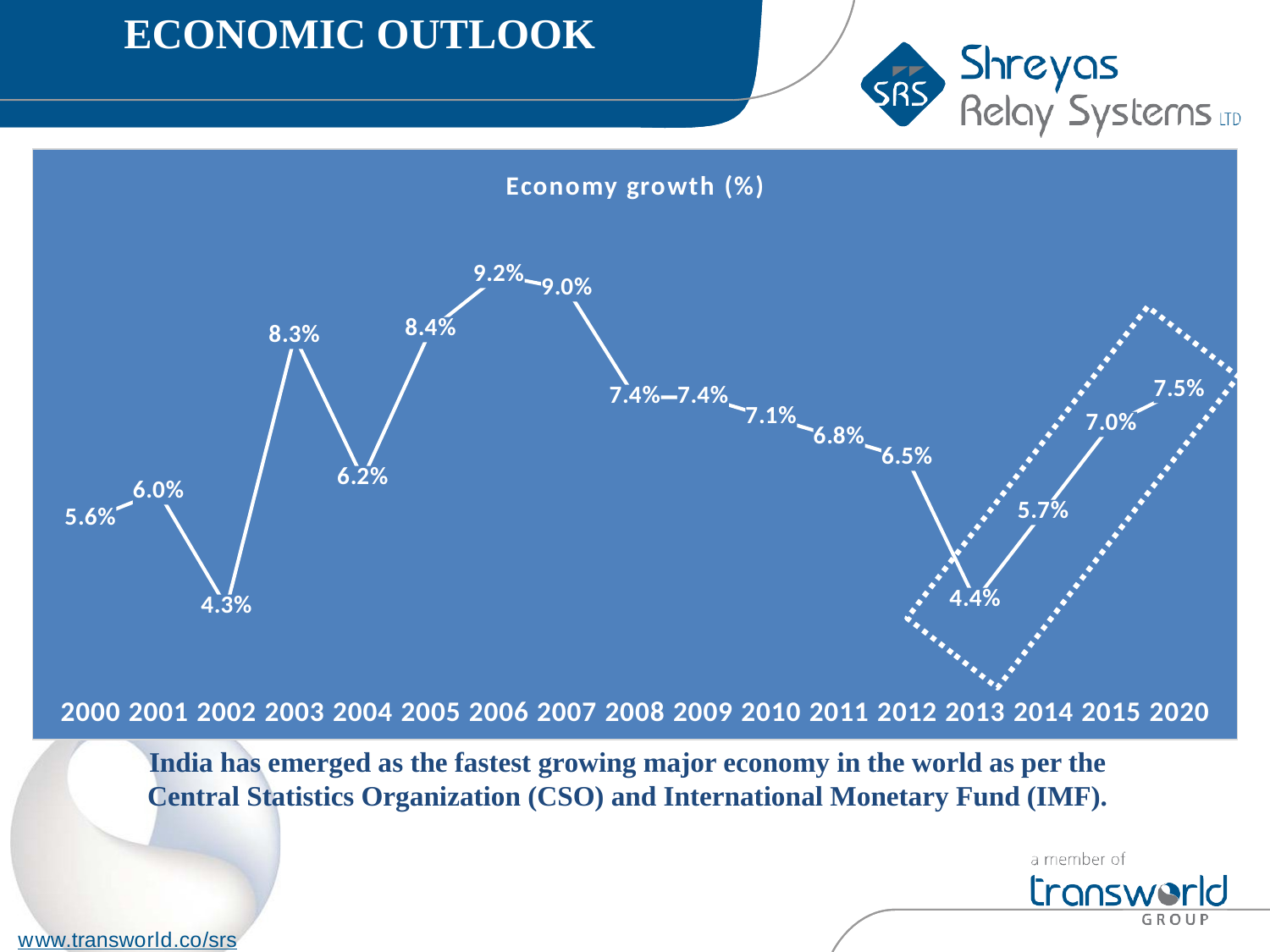
What is the difference between the economy growth values for 2003 and 2002? 4.0 percentage points What is the economy growth value for 2013? 4.4% What is the economy growth value for 2020? 7.5% Which year has the highest economy growth value? 2006 How many years are plotted on the x axis? 17 Which year has a higher economy growth value, 2003 or 2004? 2003 What is the title of the chart? Economy growth (%) Which year has the lowest economy growth value? 2002 Do the economy growth values rise or fall from 2006 to 2013? Fall What is the economy growth value for 2006? 9.2% What is the difference between the economy growth values for 2006 and 2013? 4.8 percentage points What type of chart is shown on the slide? Line chart